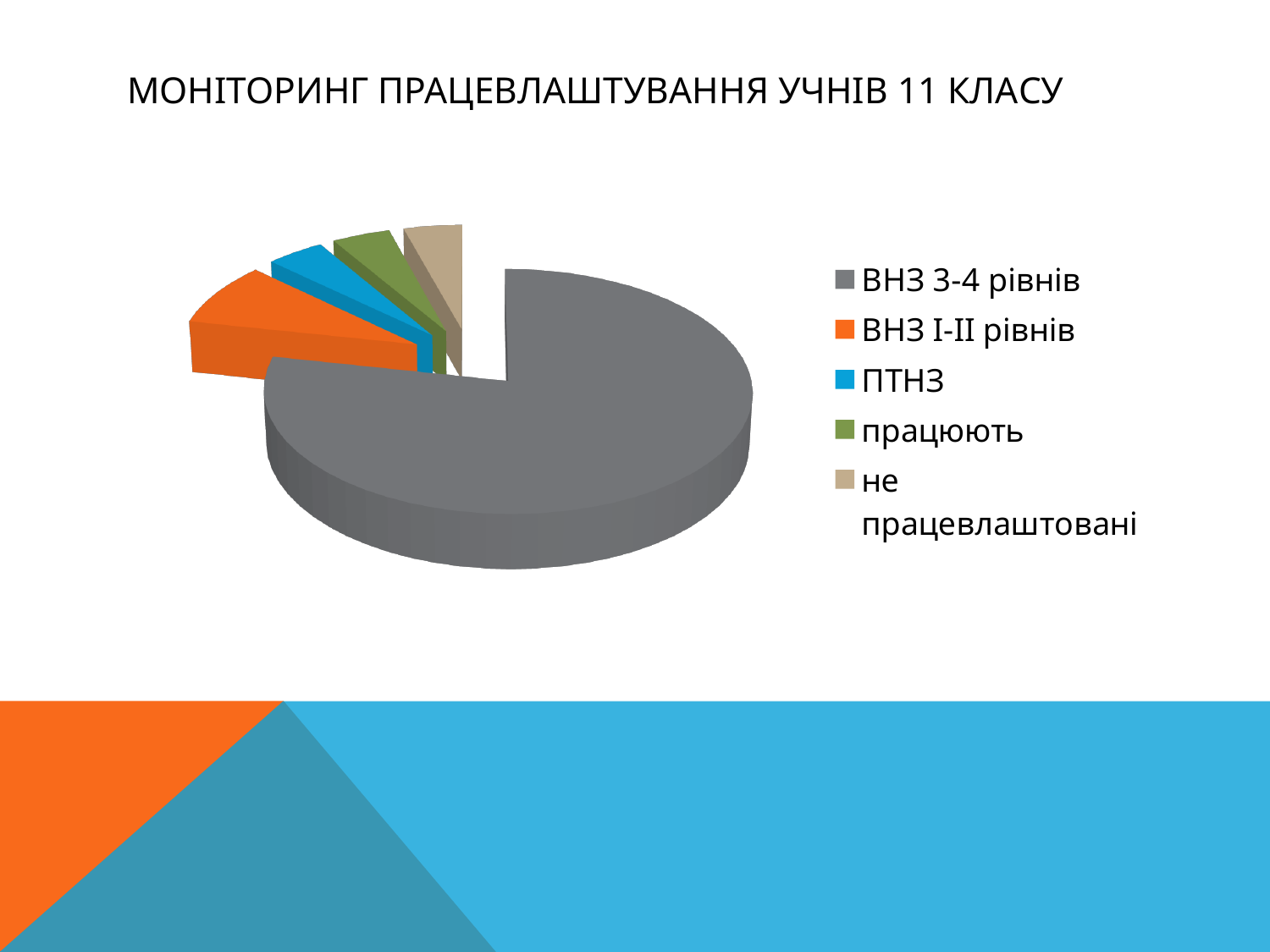
Which slice is larger: ВНЗ 3-4 рівнів or ВНЗ I-II рівнів? ВНЗ 3-4 рівнів Which slice is larger: ВНЗ I-II рівнів or ПТНЗ? ВНЗ I-II рівнів What colour represents the ПТНЗ category in the pie chart? blue Which category has the largest slice of the pie chart? ВНЗ 3-4 рівнів What kind of chart is shown on the slide? pie chart Which slice is larger: ВНЗ I-II рівнів or працюють? ВНЗ I-II рівнів How many categories (slices) does the pie chart have? 5 What is the title of the slide containing the chart? МОНІТОРИНГ ПРАЦЕВЛАШТУВАННЯ УЧНІВ 11 КЛАСУ